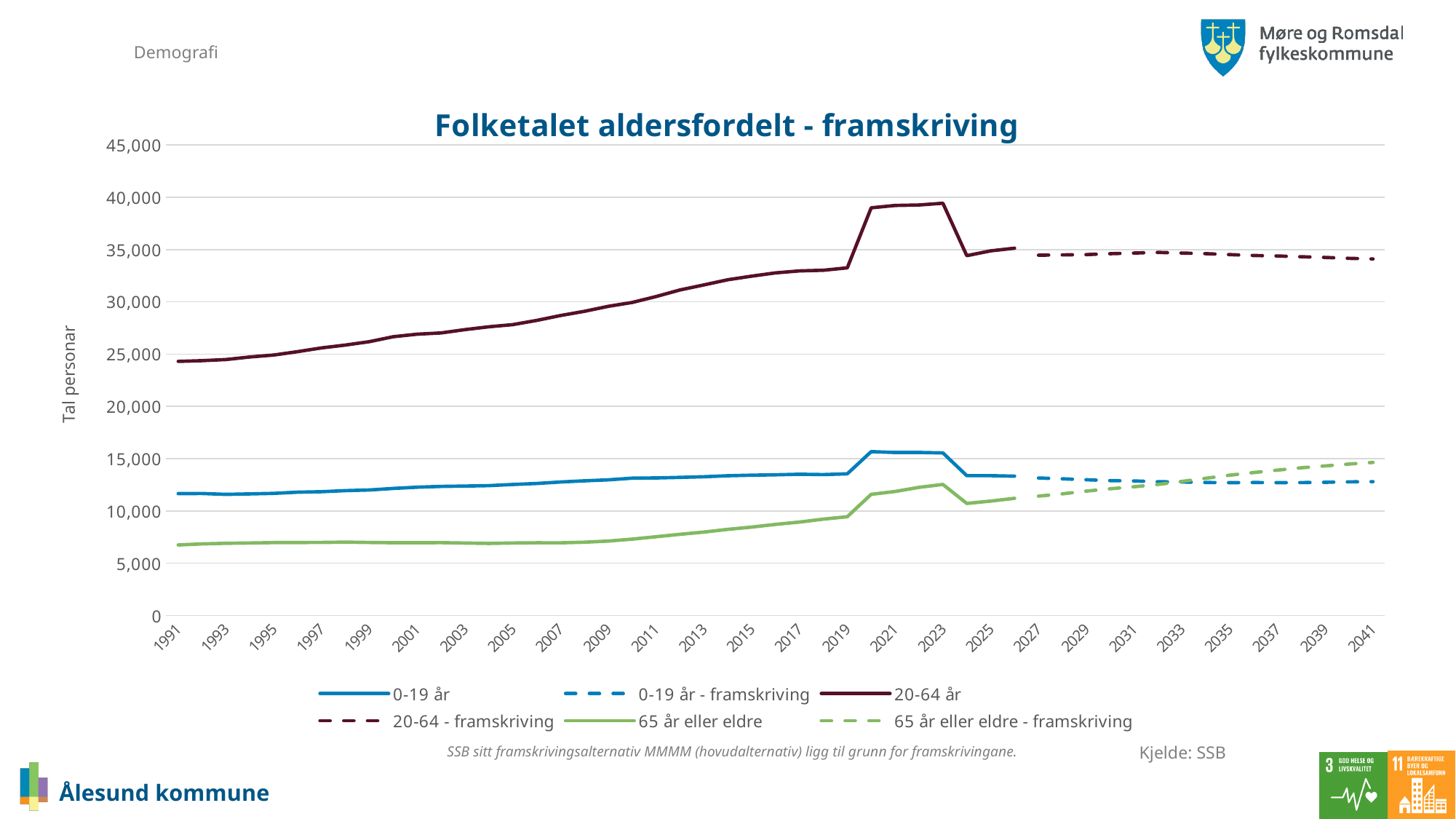
What kind of chart is shown on the slide? Line chart Is the value for 0-19 år in 1991 greater or less than 10,000? greater Is the value for 20-64 år in 2015 greater or less than 30,000? greater What is the label on the y axis of the chart? Tal personar In 2019, which is larger: 0-19 år or 65 år eller eldre? 0-19 år Does the 65 år eller eldre series rise or fall from 1991 to 2025? Rises How many series does the legend list? 6 Is the value for 20-64 år in 2021 greater or less than 35,000? greater In 2041, which projected series is larger: 0-19 år - framskriving or 65 år eller eldre - framskriving? 65 år eller eldre - framskriving What is the title of the chart? Folketalet aldersfordelt - framskriving Which series has the highest values across the whole chart? 20-64 år